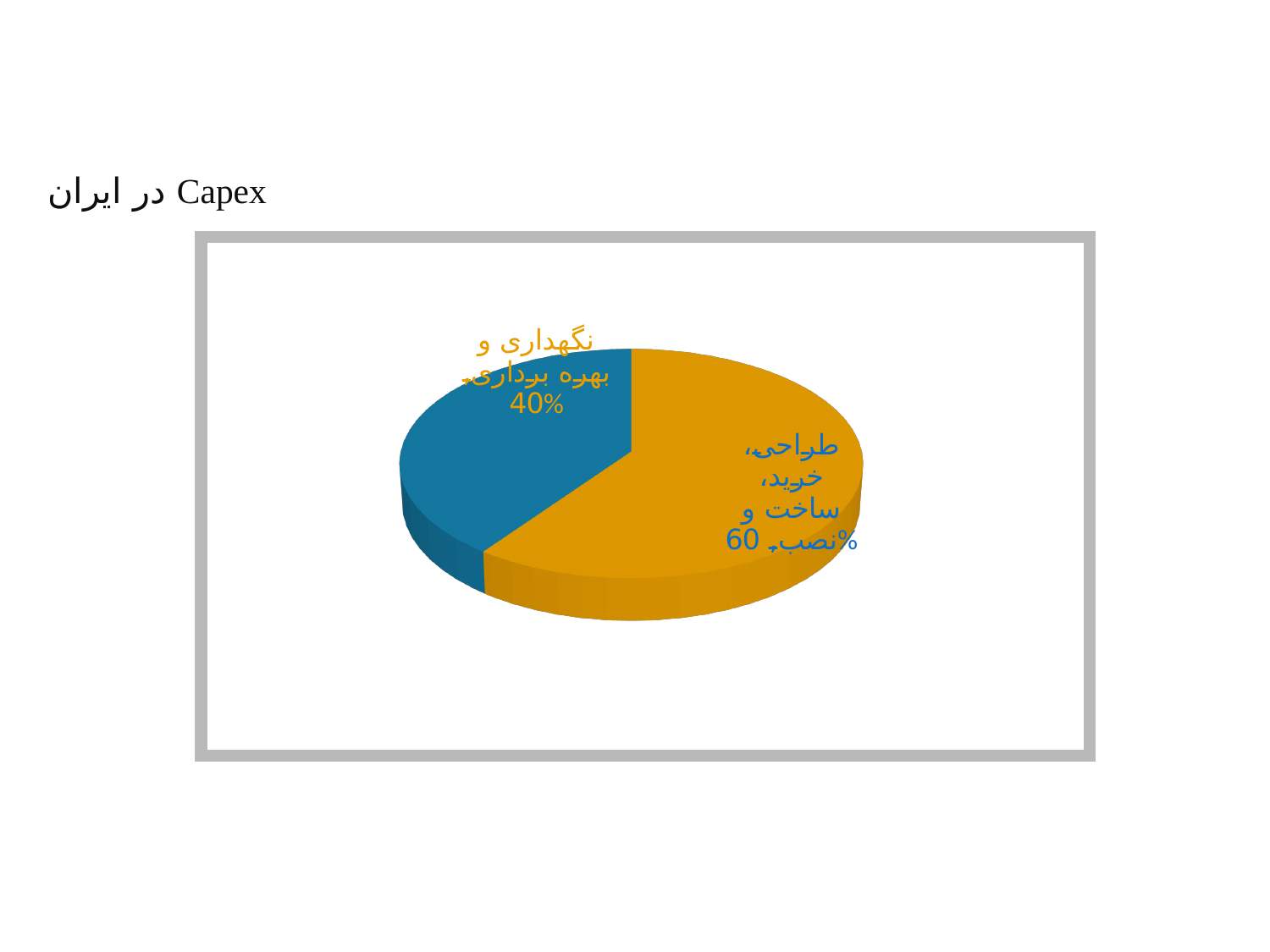
What colour is the slice for نگهداری و بهره برداری? blue Which slice of the pie chart is the largest? طراحی، خرید، ساخت و نصب What is the total of the two slice percentages shown on the pie chart? 100% Which is larger: the slice for نگهداری و بهره برداری or the slice for طراحی، خرید، ساخت و نصب? طراحی، خرید، ساخت و نصب What is the difference in percentage points between the two slices of the pie chart? 20% Which slice of the pie chart is the smallest? نگهداری و بهره برداری What kind of chart is shown on the slide? pie chart How many slices does the pie chart have? 2 What colour is the slice for طراحی، خرید، ساخت و نصب? orange What share of the pie is labelled نگهداری و بهره برداری? 40% What share of the pie is labelled طراحی، خرید، ساخت و نصب? 60%